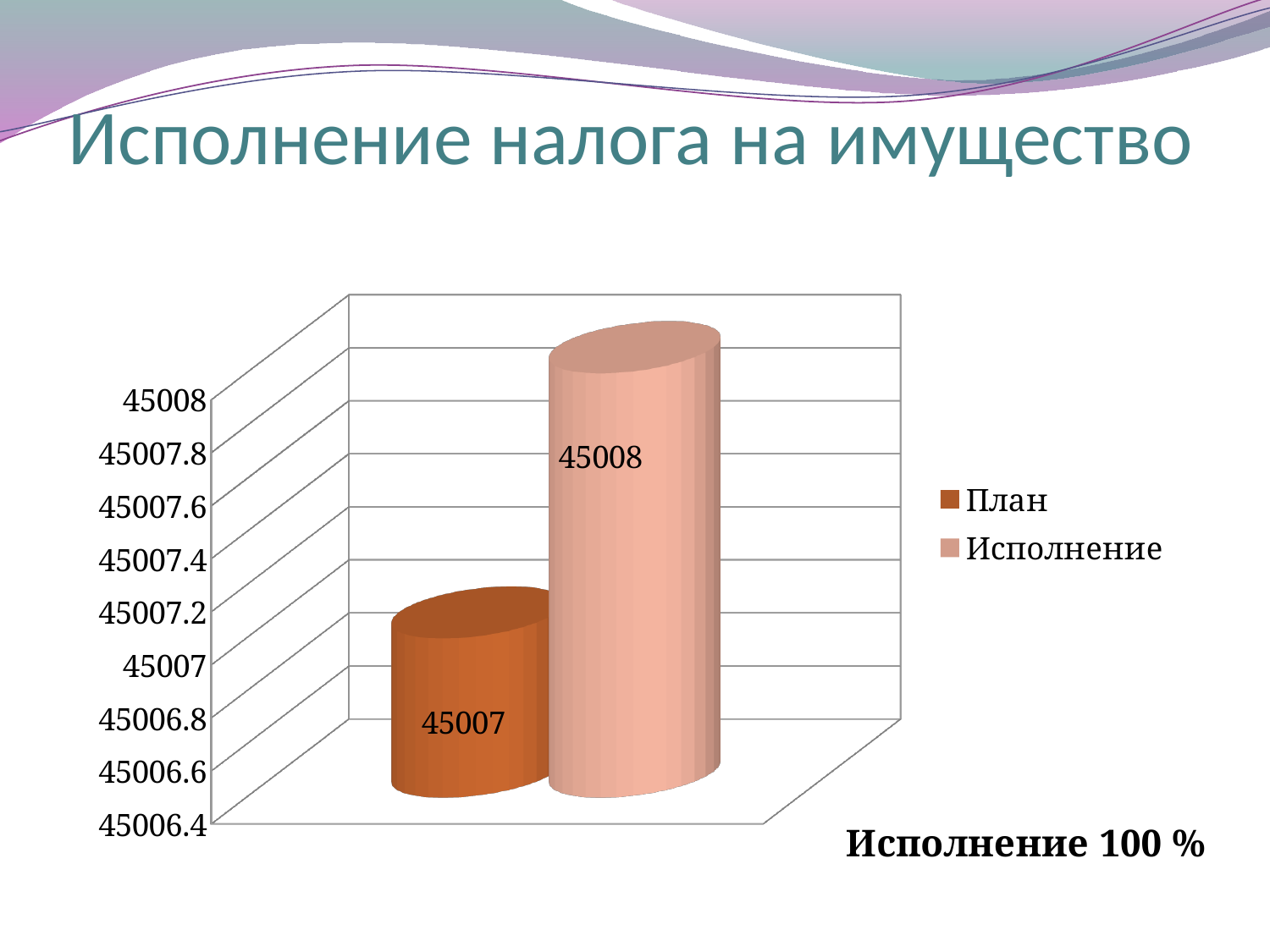
Which series has the lowest value? План What kind of chart is shown on the slide? Bar chart What execution percentage is stated below the chart? 100 % What is the title of the slide? Исполнение налога на имущество What is the value for План (Plan)? 45007 Which series has the higher value, План or Исполнение? Исполнение How many series does the legend list? 2 How many bars are plotted on the chart? 2 Is the value for План greater or less than 45007.4? less What is the value for Исполнение (Execution)? 45008 What is the difference between the Исполнение value and the План value? 1